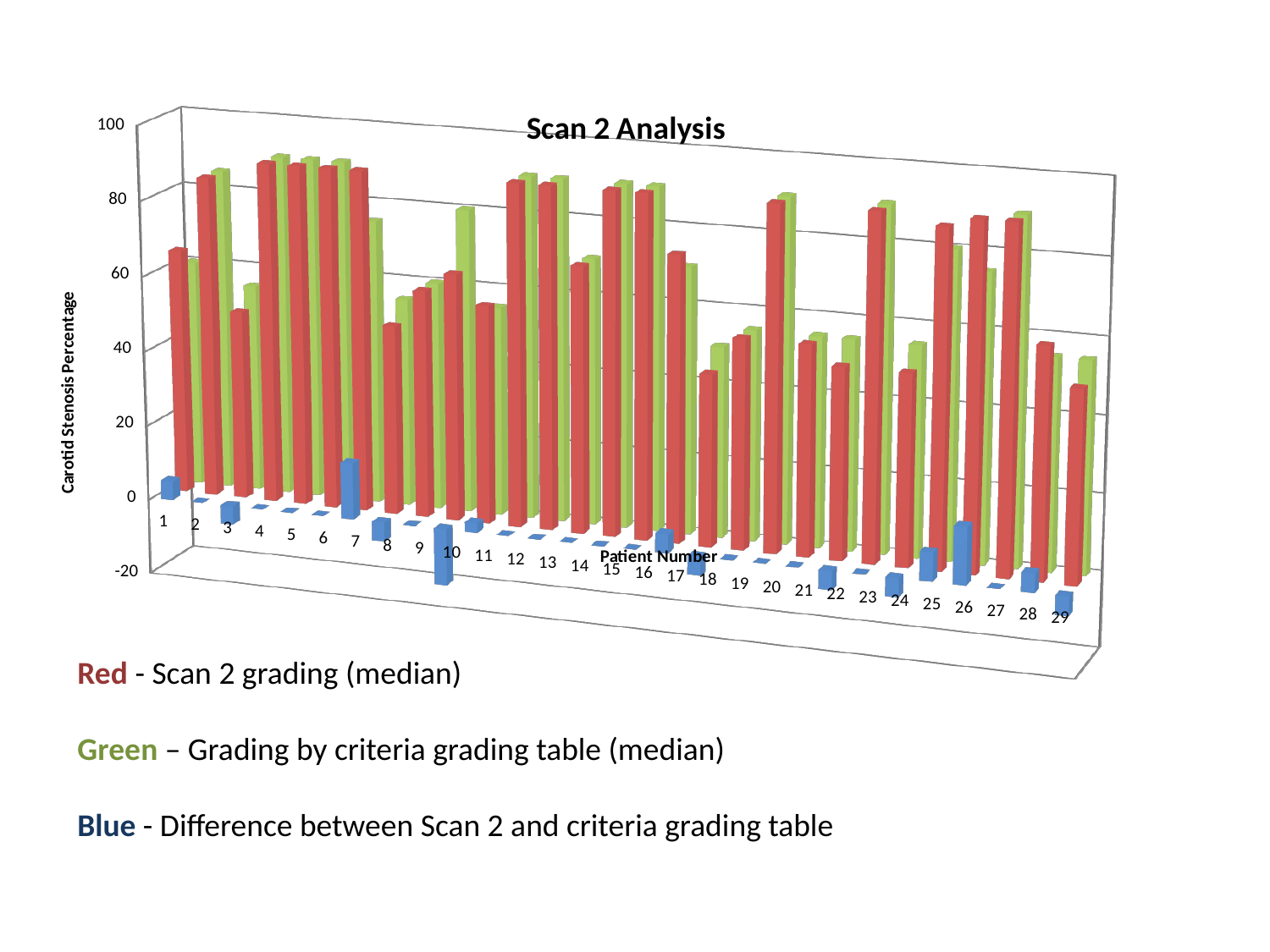
Is the blue (difference) value for patient 7 greater or less than 0? greater Is the green (criteria grading table) value for patient 29 greater or less than 60? less Which has the larger red (Scan 2 grading) value, patient 4 or patient 18? Patient 4 Is the red (Scan 2 grading) value for patient 4 greater or less than 80? greater For patient 10, which is larger, the red (Scan 2 grading) bar or the green (criteria grading table) bar? Green How many patients are plotted along the x axis of the chart? 29 How many data series (colours) are plotted in the chart? 3 What kind of chart is shown on the slide? Bar chart What is the title of the chart? Scan 2 Analysis What is the label of the vertical axis of the chart? Carotid Stenosis Percentage